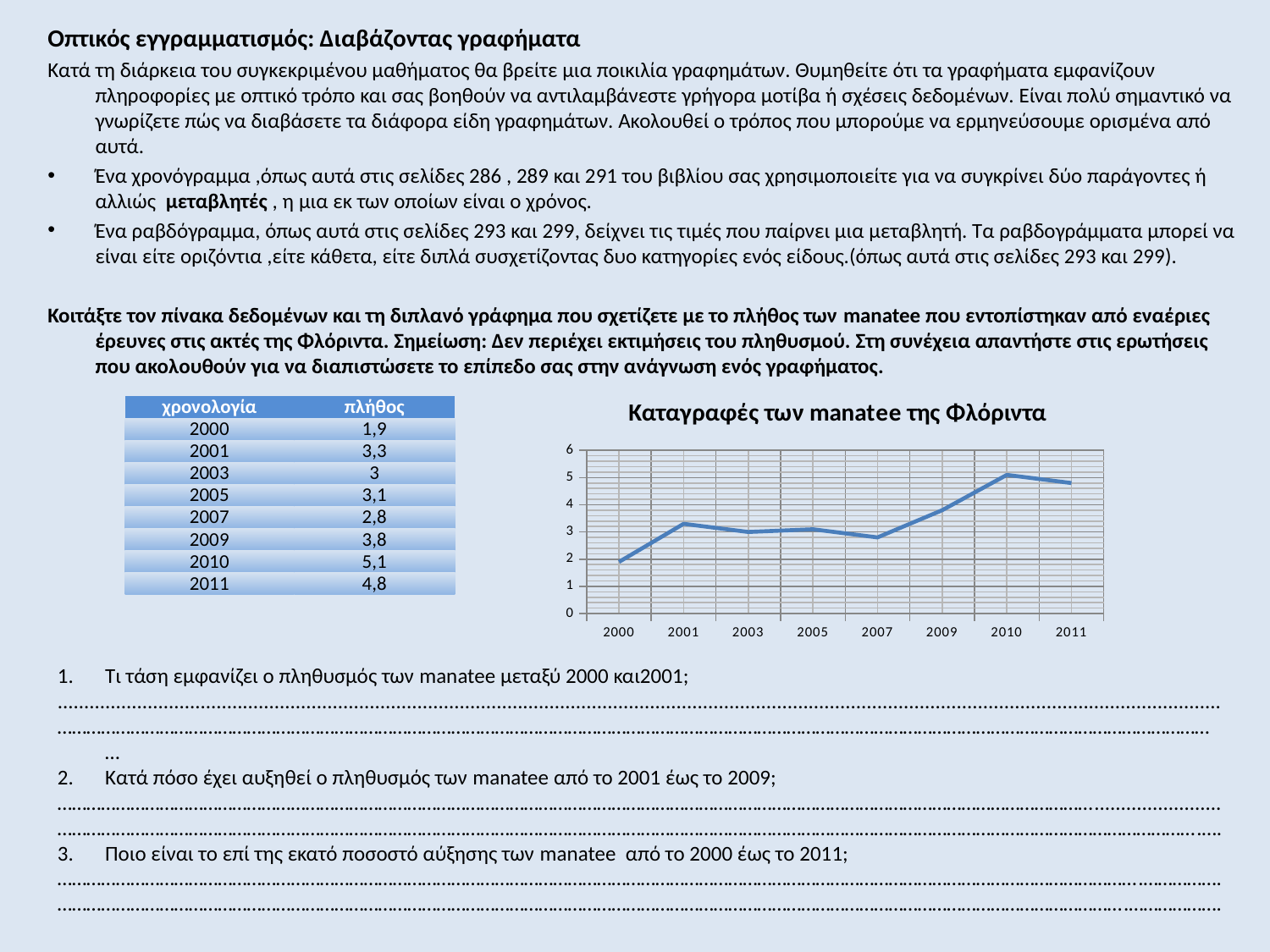
Is the value for 2010 greater or less than 4? greater In which year does the line reach its highest value? 2010 According to the table, what is the value (πλήθος) for 2000? 1,9 Does the line rise or fall between 2000 and 2001? rises What kind of chart is shown on the slide? line chart Which year has the larger value, 2010 or 2011? 2010 In which year does the line have its lowest value? 2000 By how much does the value increase from 2001 to 2009, using the table values? 0,5 What is the title of the chart? Καταγραφές των manatee της Φλόριντα How many years are plotted along the x axis of the chart? 8 According to the table, what is the value (πλήθος) for 2010? 5,1 What is the difference between the values for 2011 and 2000, using the table values? 2,9